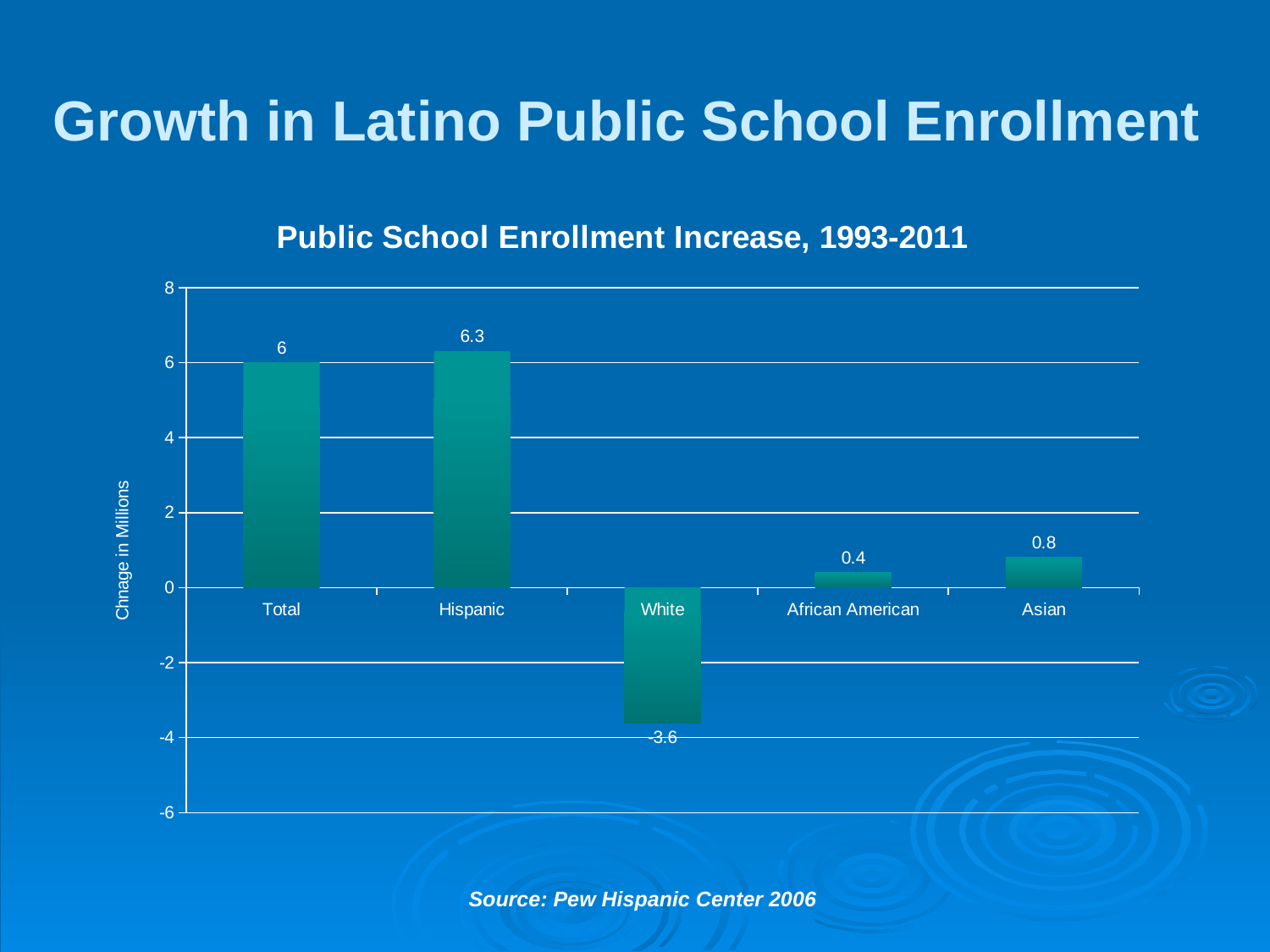
What is the difference between the Hispanic value and the Total value? 0.3 What is the value for Hispanic in the Public School Enrollment Increase chart? 6.3 What is the value for White in the chart? -3.6 What is the label on the vertical axis? Chnage in Millions Which category has the lowest value? White Which is larger, the value for Asian or the value for African American? Asian What is the value for Asian? 0.8 How many categories are shown on the x axis? 5 What is the title of the chart? Public School Enrollment Increase, 1993-2011 What kind of chart is shown on the slide? Bar chart What is the value for African American? 0.4 Which category has the highest value? Hispanic